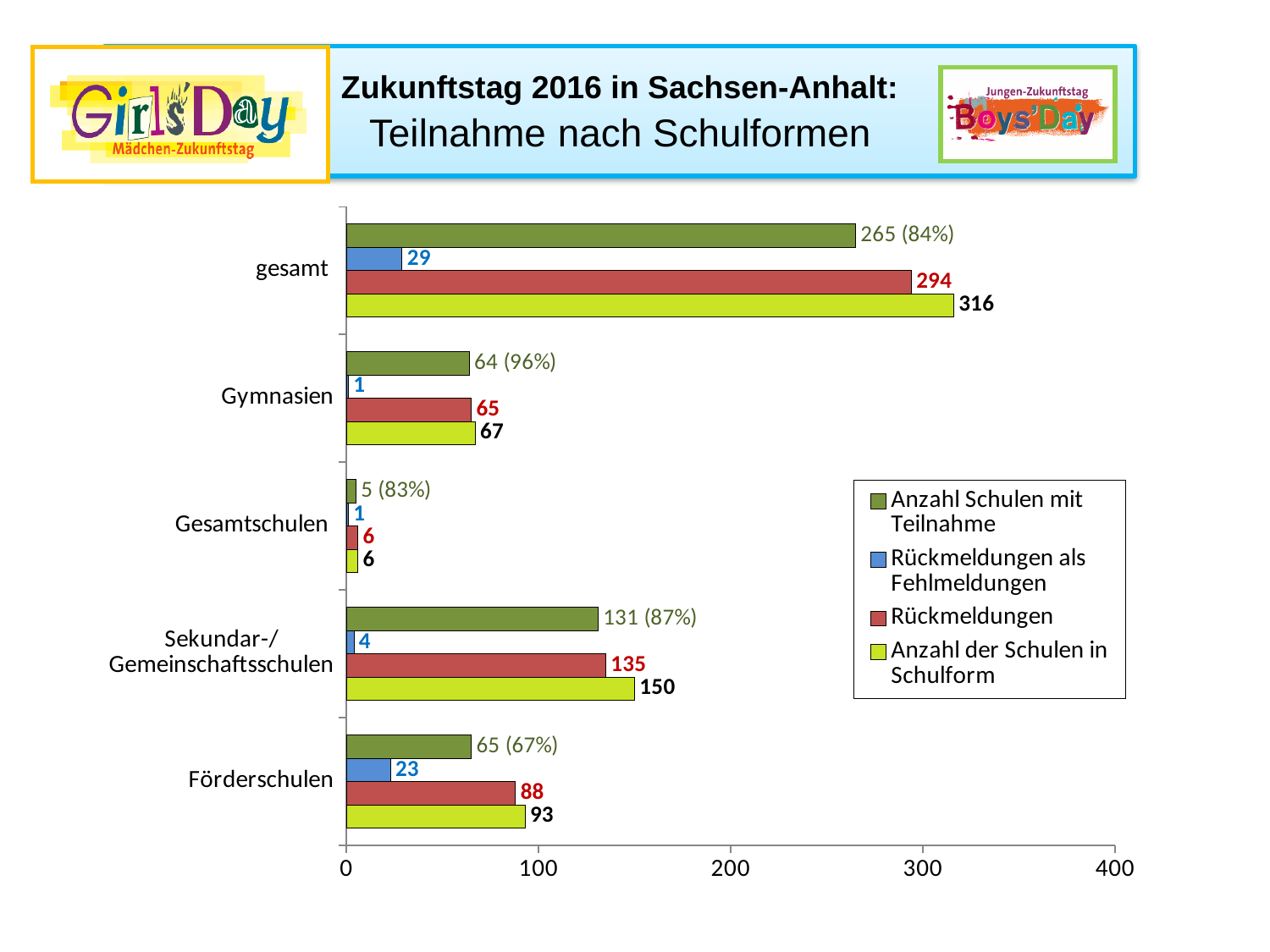
How many series does the legend list? 4 Which series is shown in blue in the legend? Rückmeldungen als Fehlmeldungen What is the value of 'Rückmeldungen als Fehlmeldungen' for gesamt? 29 Which category has the lowest value for 'Anzahl der Schulen in Schulform'? Gesamtschulen What is the value of 'Anzahl der Schulen in Schulform' for Förderschulen? 93 What is the value of 'Rückmeldungen' for Sekundar-/Gemeinschaftsschulen? 135 What is the difference between 'Anzahl der Schulen in Schulform' and 'Rückmeldungen' for Förderschulen? 5 What is the data label for 'Anzahl Schulen mit Teilnahme' for Gymnasien? 64 (96%) How many categories are shown on the vertical axis? 5 Is the 'Rückmeldungen' value for Sekundar-/Gemeinschaftsschulen larger or smaller than the 'Rückmeldungen' value for Förderschulen? larger What kind of chart is shown on the slide? bar chart Excluding gesamt, which school form has the highest value for 'Rückmeldungen als Fehlmeldungen'? Förderschulen